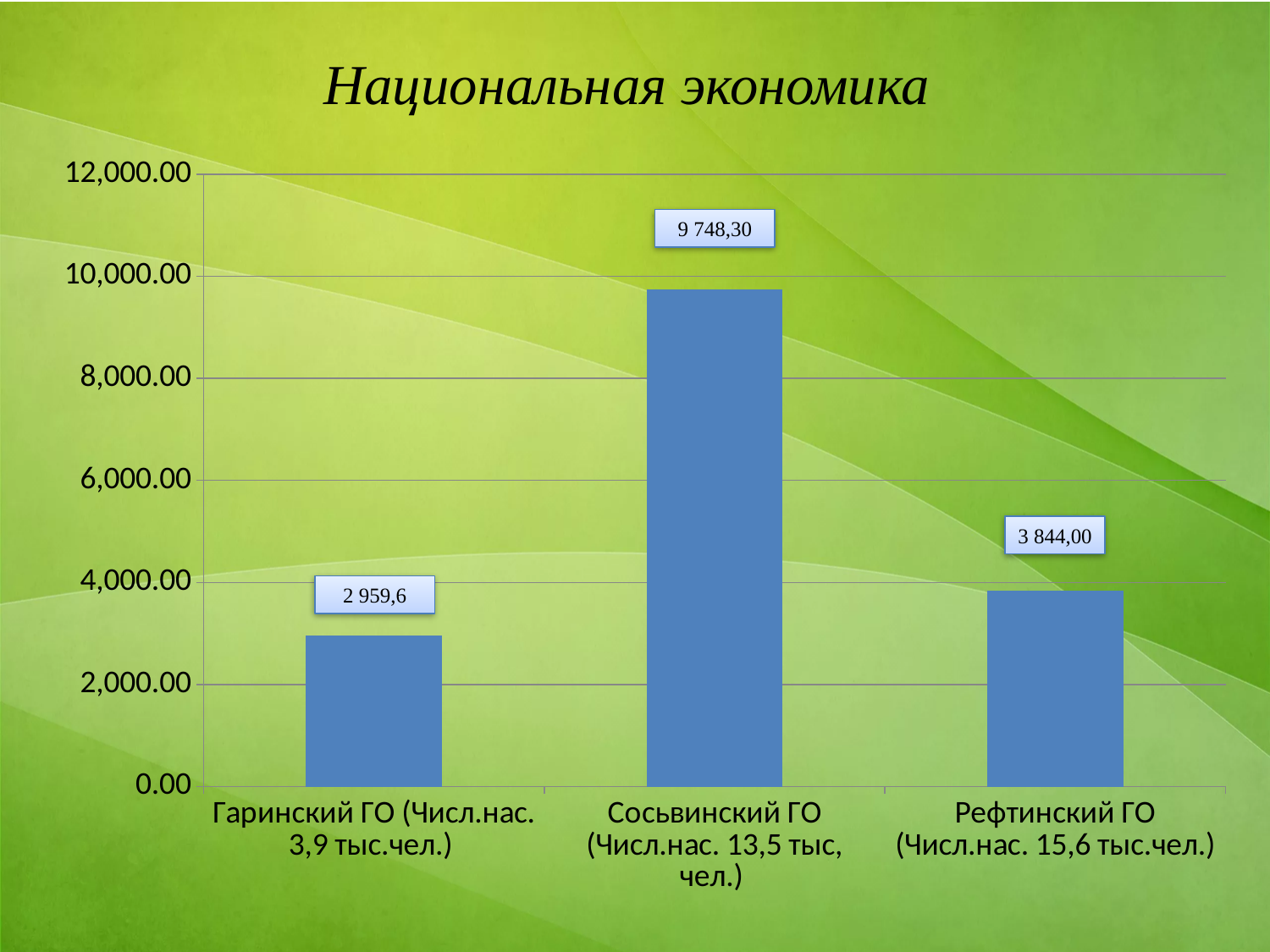
What is the value for Рефтинский ГО? 3 844,00 What kind of chart is shown on the slide? bar chart Is the value for Сосьвинский ГО greater or less than 8,000.00? greater Which category has the lowest value? Гаринский ГО What is the title of the slide? Национальная экономика What is the difference between the values for Сосьвинский ГО and Гаринский ГО? 6 788,70 What is the difference between the values for Рефтинский ГО and Гаринский ГО? 884,40 How many categories are shown in the chart? 3 What is the value for Сосьвинский ГО? 9 748,30 Which is larger, the value for Рефтинский ГО or the value for Гаринский ГО? Рефтинский ГО Which category has the highest value? Сосьвинский ГО What is the value for Гаринский ГО? 2 959,6